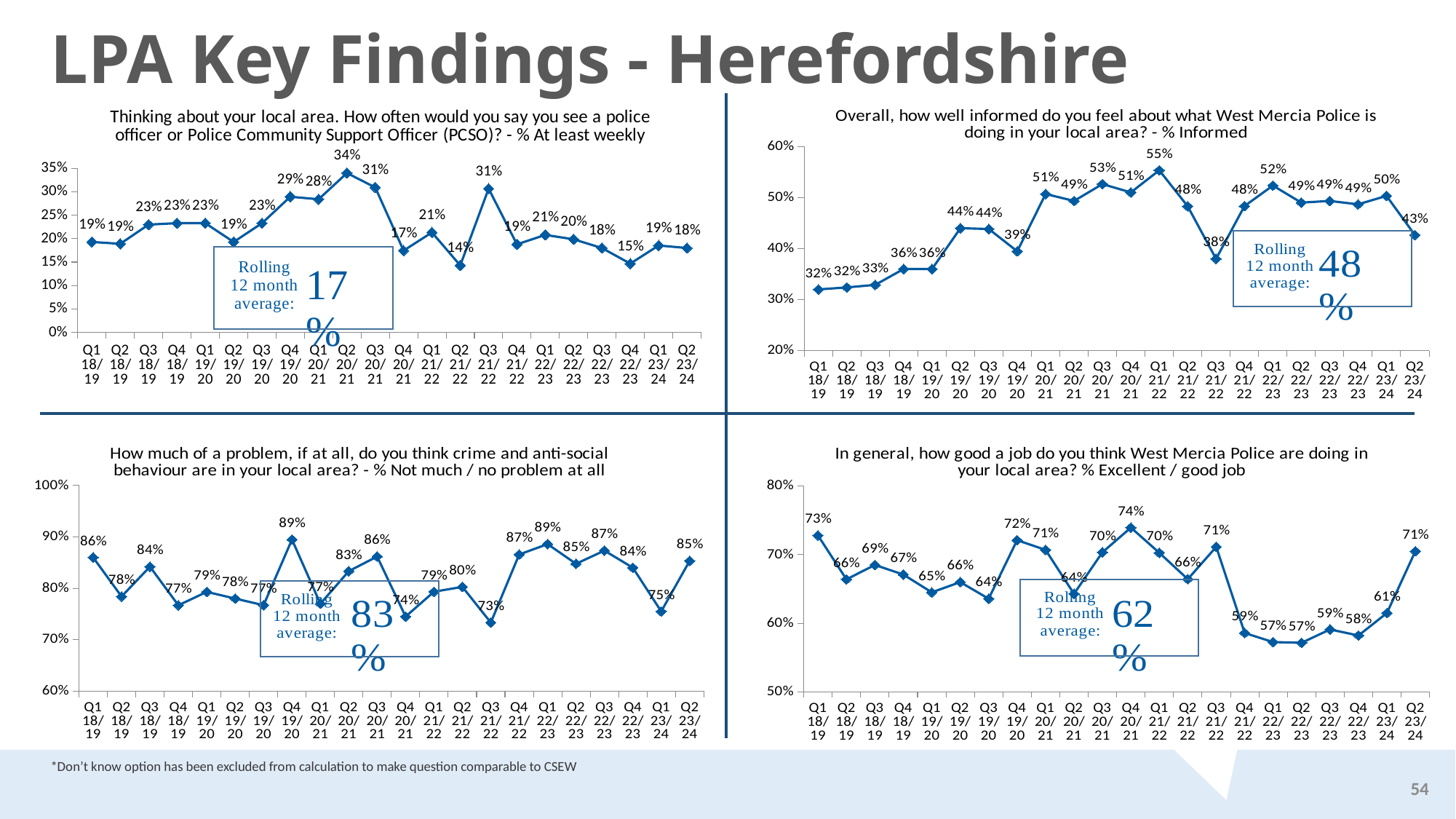
In the chart about how often people see a police officer or PCSO (% At least weekly), what is the value for Q2 20/21? 34% In the chart about how often people see a police officer or PCSO (% At least weekly), what is the rolling 12 month average shown? 17% In the chart about how well informed people feel about what West Mercia Police is doing (% Informed), what is the value for Q2 23/24? 43% In the chart about how often people see a police officer or PCSO (% At least weekly), which quarter has the lowest value? Q2 21/22 What type of chart is used in the chart about how well informed people feel about what West Mercia Police is doing (% Informed)? line chart In the chart about how good a job West Mercia Police are doing (% Excellent / good job), what is the value for Q4 20/21? 74% In the chart about how well informed people feel about what West Mercia Police is doing (% Informed), which quarter has the highest value? Q1 21/22 In the chart about how good a job West Mercia Police are doing (% Excellent / good job), is the value for Q1 22/23 larger or smaller than the value for Q1 18/19? smaller In the chart about crime and anti-social behaviour (% Not much / no problem at all), which quarter has the lowest value? Q3 21/22 In the chart about how well informed people feel about what West Mercia Police is doing (% Informed), what is the difference between Q1 21/22 and Q3 21/22? 17% How many quarters are plotted in the chart about how good a job West Mercia Police are doing (% Excellent / good job)? 22 In the chart about crime and anti-social behaviour (% Not much / no problem at all), what is the value for Q4 19/20? 89%